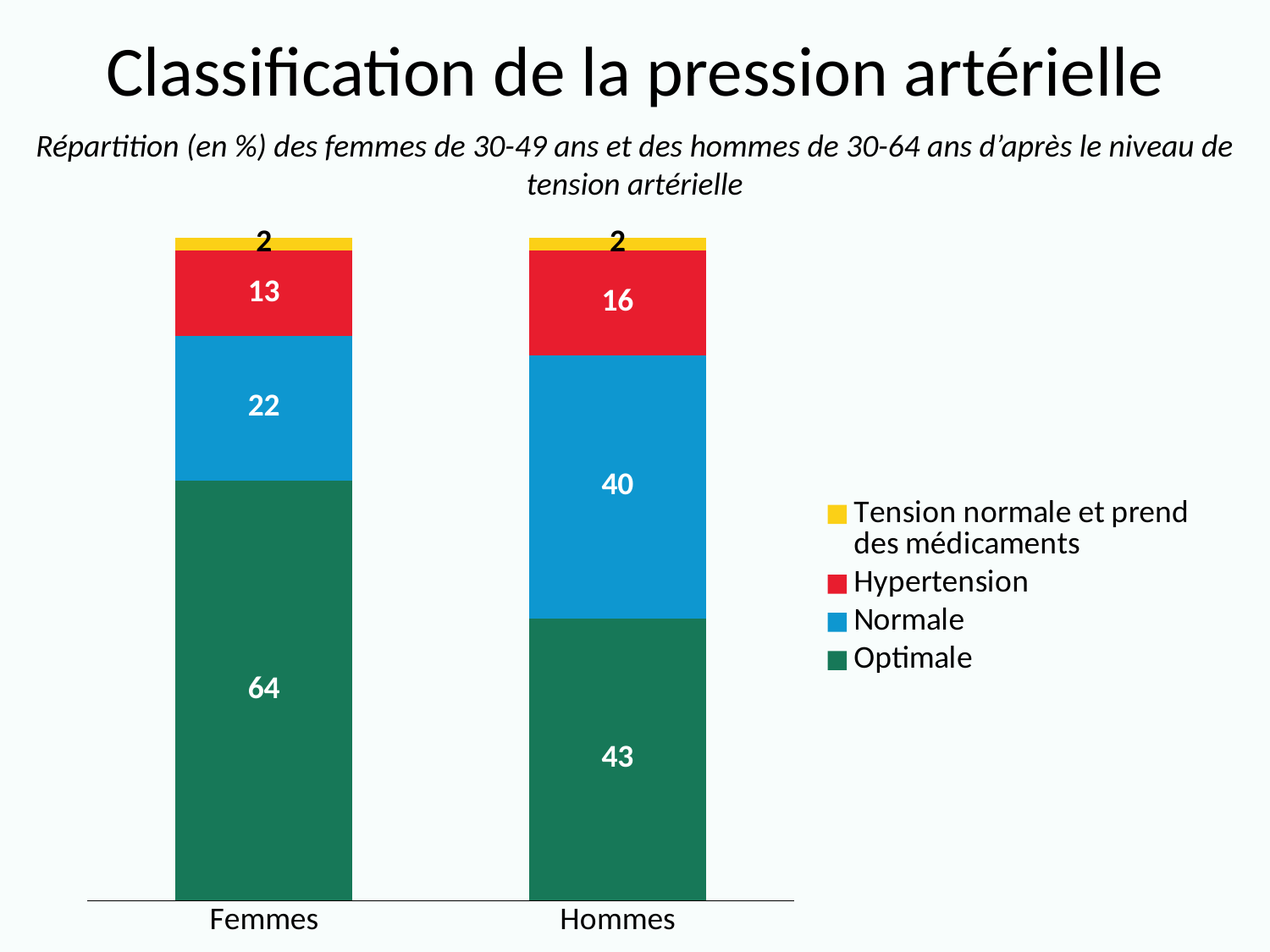
Which category has the higher Optimale value, Femmes or Hommes? Femmes What is the difference between the Hypertension values for Hommes and Femmes? 3 What is the Hypertension value for Hommes? 16 What is the total of the stacked bar for Femmes? 101 What kind of chart is shown on the slide? Stacked bar chart What is the Normale value for Hommes? 40 How many series does the legend list? 4 How many categories are shown on the x axis? 2 What is the difference between the Optimale values for Femmes and Hommes? 21 Which category has the higher Normale value, Femmes or Hommes? Hommes What is the Optimale value for Femmes? 64 What is the value for 'Tension normale et prend des médicaments' for Femmes? 2